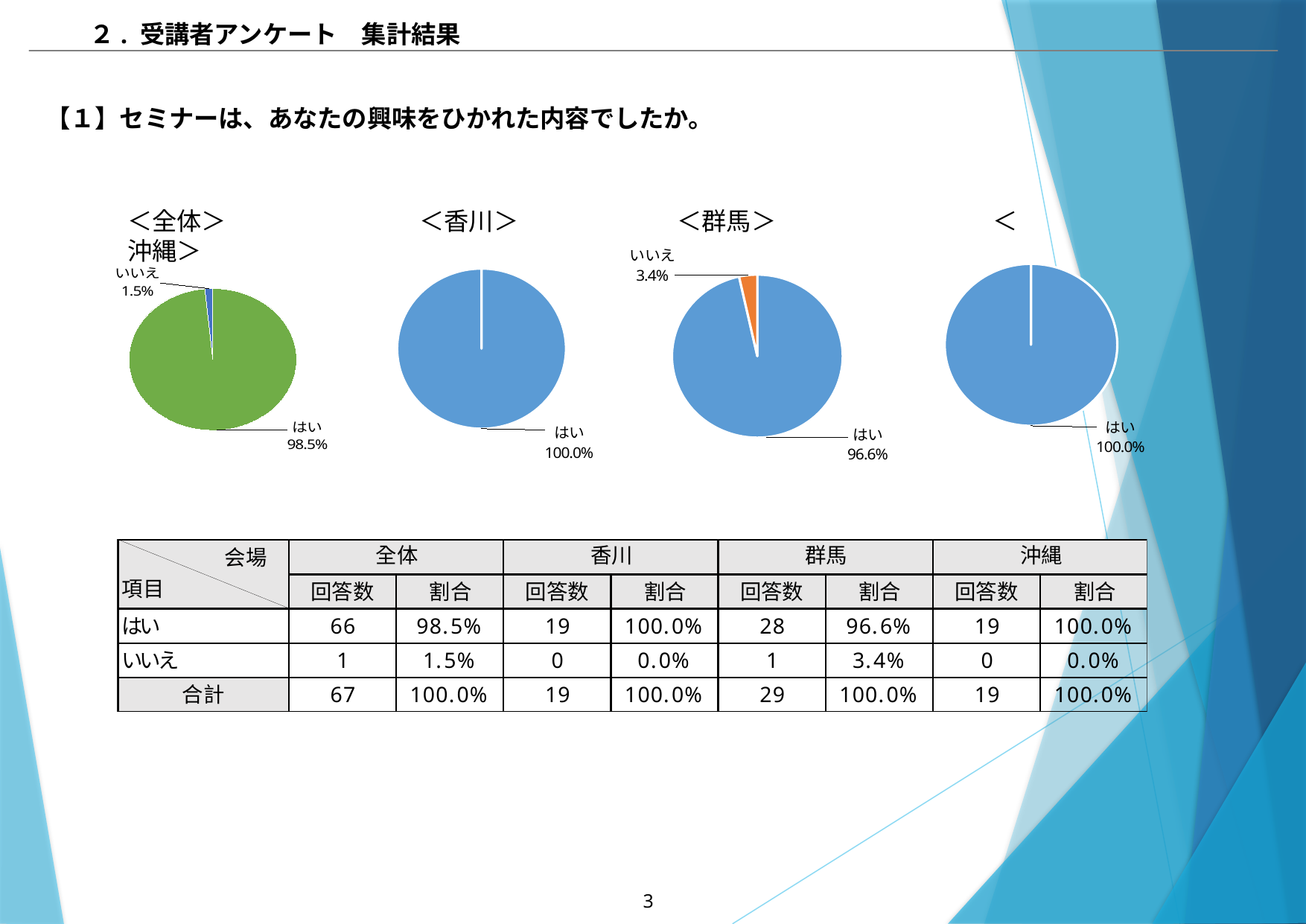
In the ＜群馬＞ pie chart, what percentage is shown for いいえ? 3.4% How many pie charts are shown on the slide? 4 In the ＜群馬＞ pie chart, what is the difference between the はい and いいえ percentages? 93.2% In the ＜全体＞ pie chart, which slice is the smallest? いいえ In the ＜全体＞ pie chart, what percentage is shown for はい? 98.5% In the ＜香川＞ pie chart, what percentage is shown for はい? 100.0% How many labelled slices does the ＜群馬＞ pie chart have? 2 In the ＜群馬＞ pie chart, which slice is the largest? はい In the ＜全体＞ pie chart, what percentage is shown for いいえ? 1.5% What type of chart is used for the ＜香川＞ results? Pie chart Which is larger: the いいえ share in the ＜全体＞ chart or the いいえ share in the ＜群馬＞ chart? ＜群馬＞ In the ＜群馬＞ pie chart, what percentage is shown for はい? 96.6%